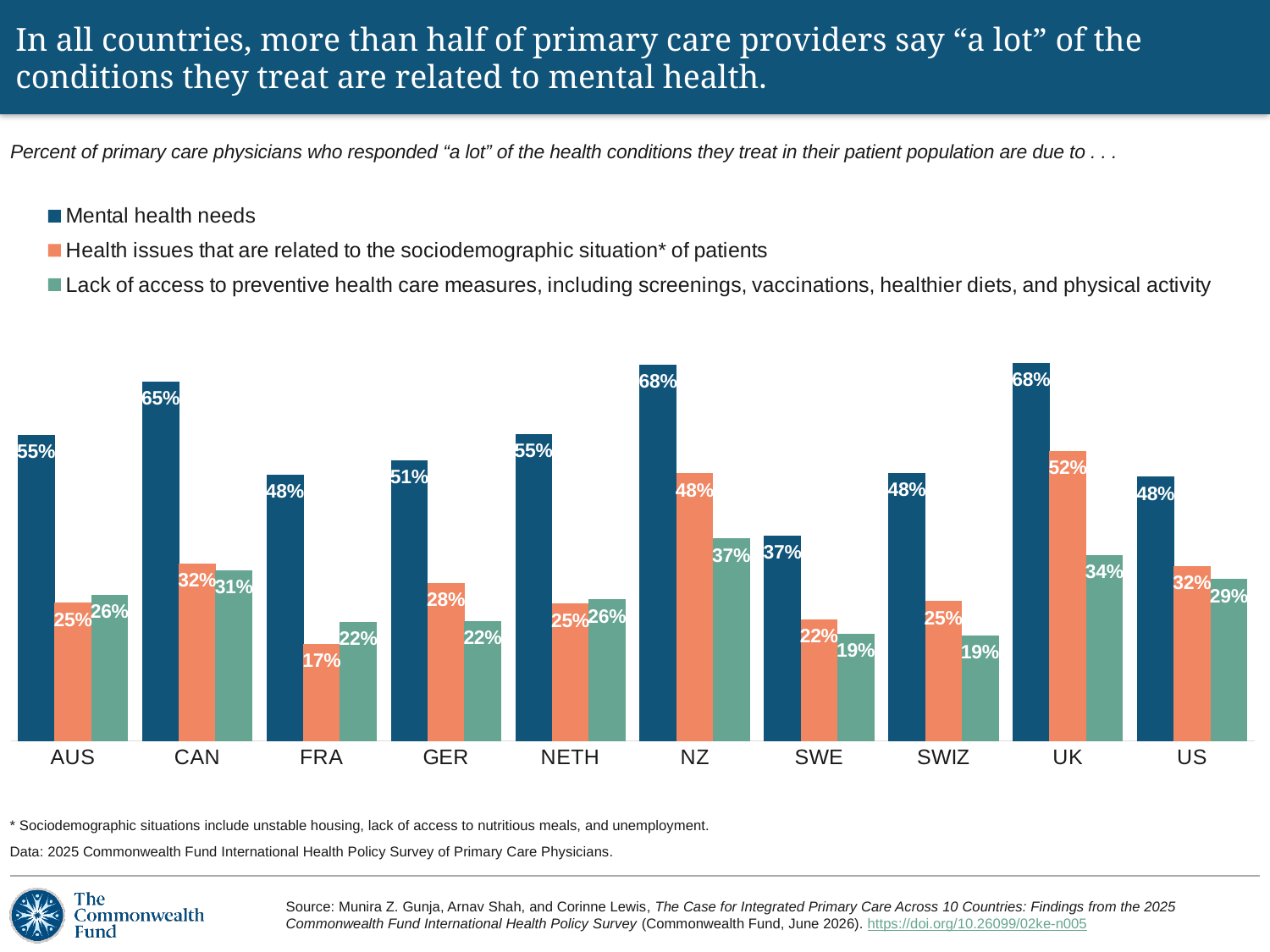
What percent of primary care physicians in Canada said "a lot" of conditions are due to mental health needs? 65% Which colour represents mental health needs in the chart? Dark blue How many countries are shown on the x axis? 10 Which country has the lowest value for health issues related to the sociodemographic situation of patients? FRA What kind of chart is shown on the slide? Bar chart What is the difference between the mental health needs value and the sociodemographic value for Germany? 23 percentage points What is the value for NZ for lack of access to preventive health care measures? 37% Which country has the lowest value for mental health needs? SWE Which is larger for Canada: the sociodemographic value or the lack of access to preventive care value? Sociodemographic (32%) Which country has the highest value for health issues related to the sociodemographic situation of patients? UK How many series does the legend list? 3 What is the value for the UK for health issues related to the sociodemographic situation of patients? 52%